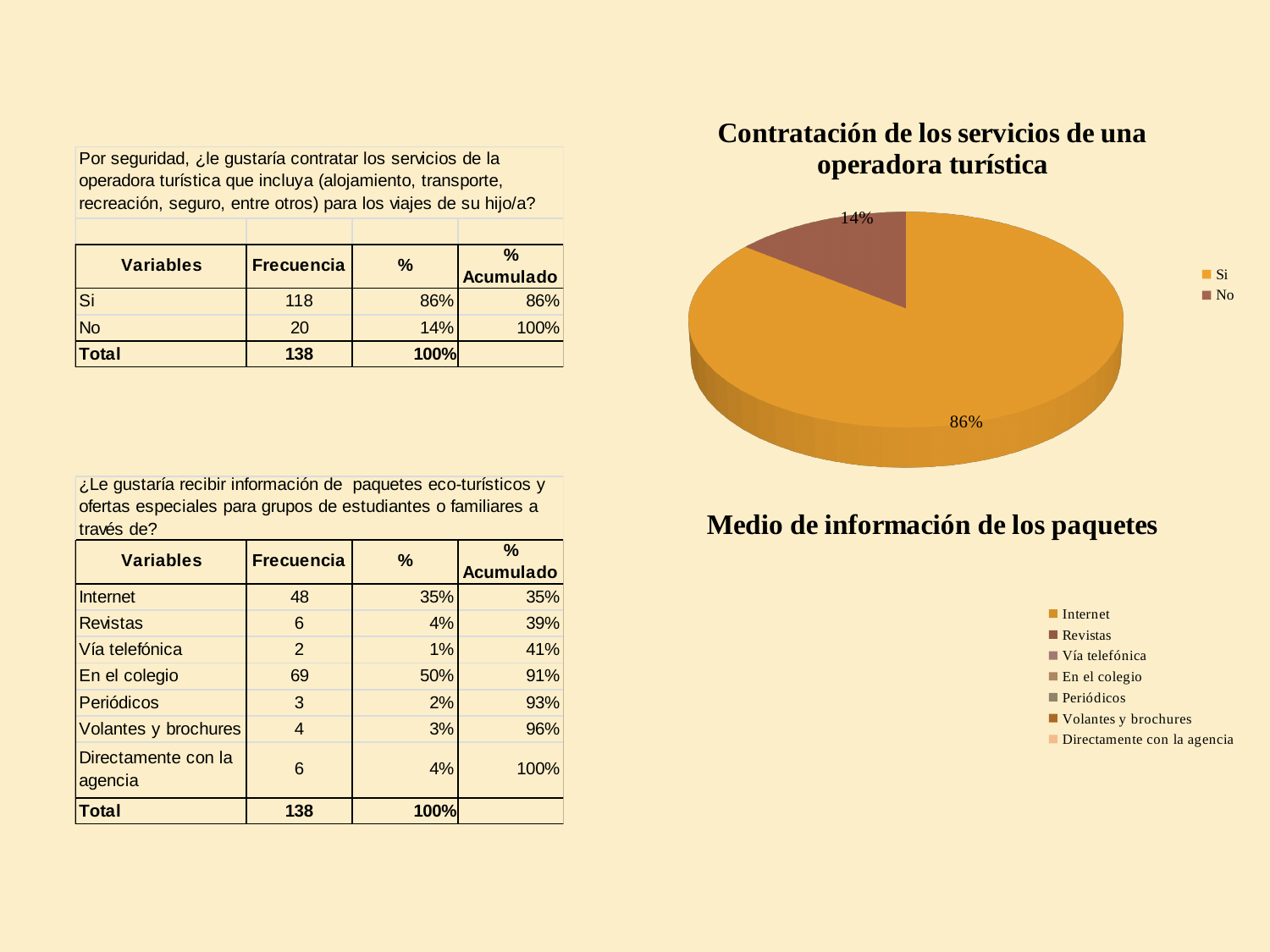
In the chart 'Contratación de los servicios de una operadora turística', what percentage is shown for 'Si'? 86% How many slices does the pie chart 'Contratación de los servicios de una operadora turística' have? 2 How many entries does the legend of the chart 'Contratación de los servicios de una operadora turística' list? 2 In the chart 'Contratación de los servicios de una operadora turística', what is the difference in percentage points between 'Si' and 'No'? 72 In the chart 'Contratación de los servicios de una operadora turística', which category has the largest slice? Si In the chart 'Contratación de los servicios de una operadora turística', which is larger, 'Si' or 'No'? Si How many entries does the legend of the chart 'Medio de información de los paquetes' list? 7 In the chart 'Contratación de los servicios de una operadora turística', what share of the pie does 'No' represent? 14% In the chart 'Contratación de los servicios de una operadora turística', which category has the smallest slice? No In the chart 'Contratación de los servicios de una operadora turística', what percentage is shown for 'No'? 14% What is the title of the pie chart at the top right of the slide? Contratación de los servicios de una operadora turística What type of chart is 'Contratación de los servicios de una operadora turística'? Pie chart